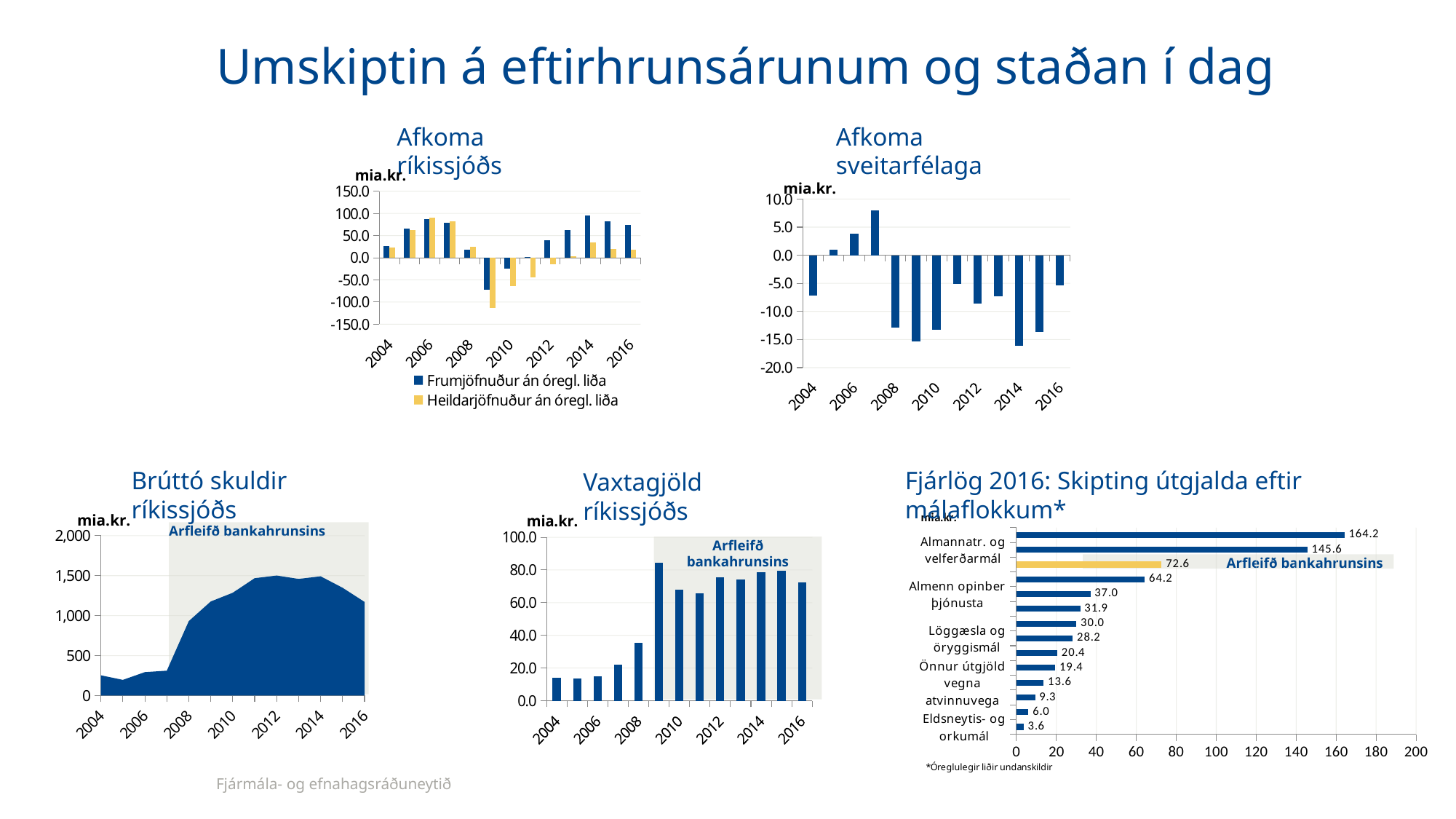
How many bars are plotted in the 'Fjárlög 2016: Skipting útgjalda eftir málaflokkum' chart? 14 In the 'Fjárlög 2016: Skipting útgjalda eftir málaflokkum' chart, what is the difference between the two largest values, 164.2 and 145.6? 18.6 In the 'Afkoma sveitarfélaga' chart, which year has the lowest value? 2014 In the 'Fjárlög 2016: Skipting útgjalda eftir málaflokkum' chart, what is the largest value shown? 164.2 What kind of chart is the 'Brúttó skuldir ríkissjóðs' chart? area chart In the 'Fjárlög 2016: Skipting útgjalda eftir málaflokkum' chart, what is the smallest value shown? 3.6 In the 'Afkoma sveitarfélaga' chart, is the value for 2007 greater or less than 5.0? greater In the 'Vaxtagjöld ríkissjóðs' chart, is the value for 2009 greater or less than 80? greater In the 'Vaxtagjöld ríkissjóðs' chart, which year has the highest value? 2009 In the 'Afkoma ríkissjóðs' chart, is the 2009 value for Heildarjöfnuður án óregl. liða greater or less than -100.0? less How many series does the legend of the 'Afkoma ríkissjóðs' chart list? 2